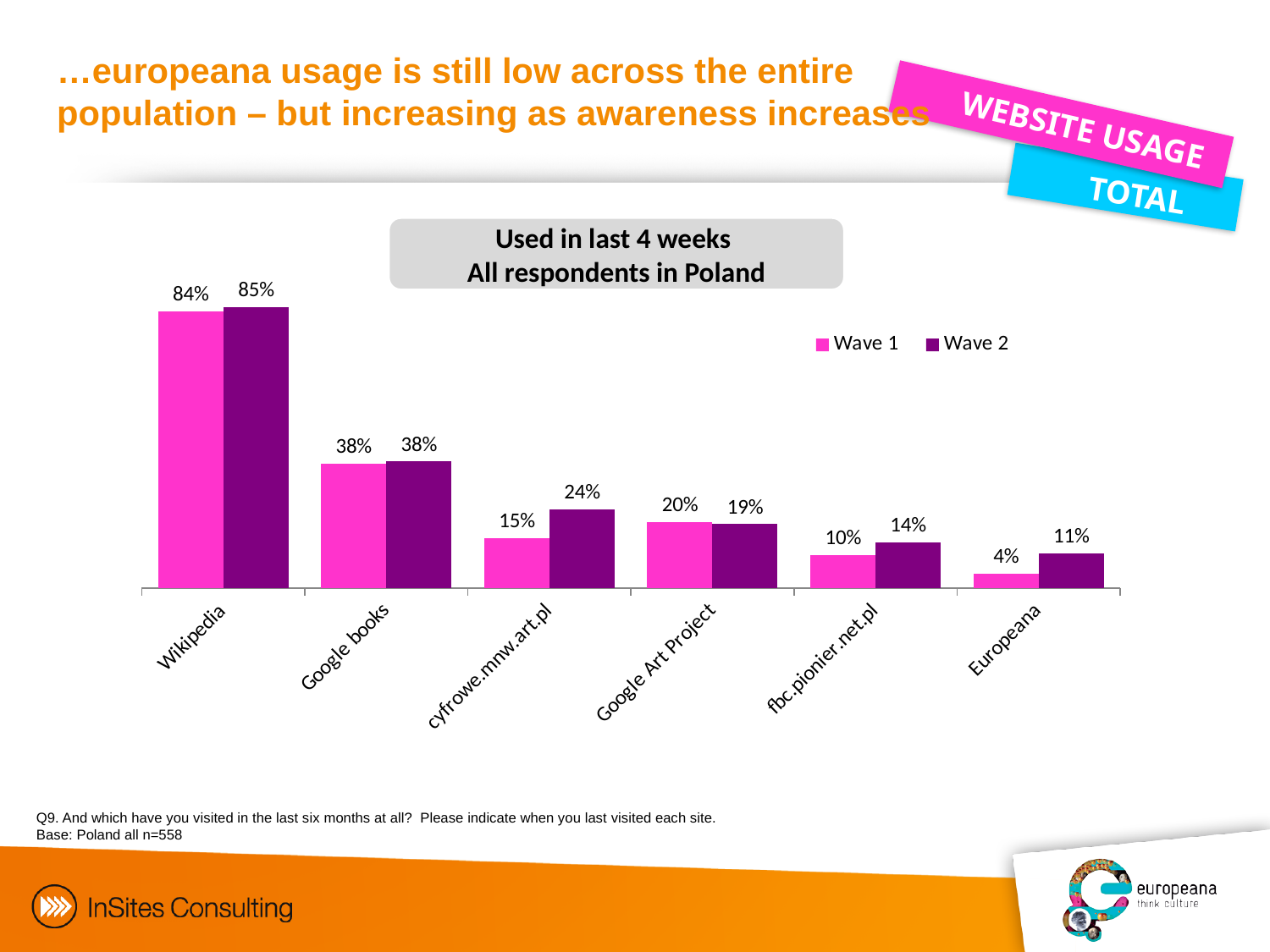
What is the title of the chart? Used in last 4 weeks All respondents in Poland For Google Art Project, which is larger: the Wave 1 value or the Wave 2 value? Wave 1 What is the Wave 2 value for Europeana? 11% What is the difference between the Wave 2 and Wave 1 values for cyfrowe.mnw.art.pl? 9% What kind of chart is shown on the slide? Bar chart What is the difference between the Wave 2 and Wave 1 values for Europeana? 7% How many websites are shown on the x axis? 6 What is the Wave 1 value for Google Art Project? 20% What is the Wave 1 value for cyfrowe.mnw.art.pl? 15% How many series does the legend list? 2 Which website has the lowest Wave 1 value? Europeana Which website has the highest Wave 2 value? Wikipedia